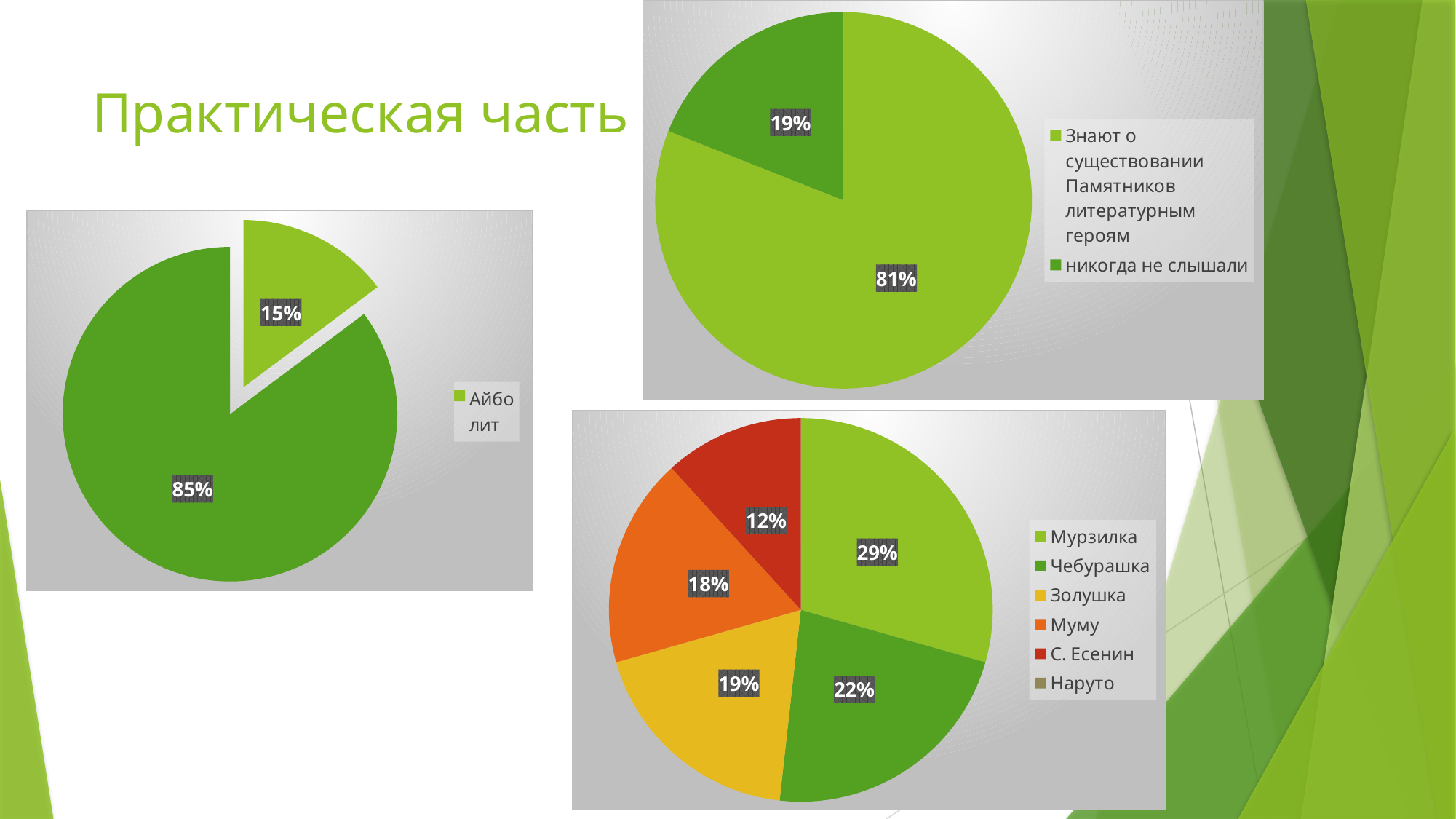
In the bottom-right pie chart, what share does Мурзилка have? 29% How many entries does the legend of the bottom-right pie chart list? 6 In the left pie chart, what share does the Айболит slice have? 15% In the bottom-right pie chart, what is the difference between the shares of Мурзилка and С. Есенин? 17% In the bottom-right pie chart, which is larger: Золушка or Муму? Золушка In the top-right pie chart, what share of respondents know about the existence of monuments to literary heroes? 81% In the bottom-right pie chart, which legend entry has the largest slice? Мурзилка In the bottom-right pie chart, which labelled slice is the smallest? С. Есенин In the bottom-right pie chart, what share does Муму have? 18% In the bottom-right pie chart, what share does Чебурашка have? 22% In the top-right pie chart, what share of respondents 'никогда не слышали'? 19% What type of chart is the left chart on the slide? pie chart